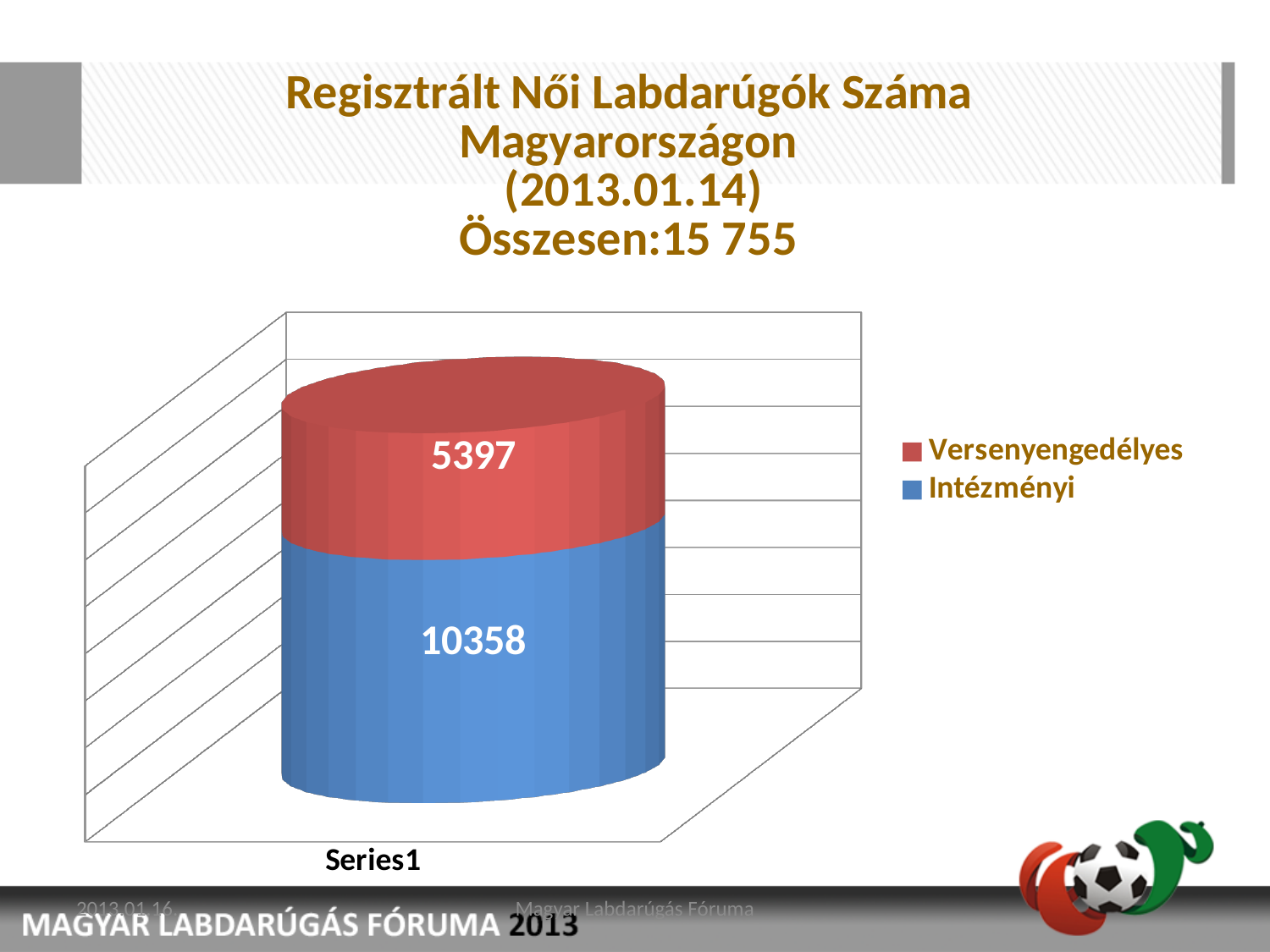
How many series does the legend list? 2 What is the value of the Versenyengedélyes segment? 5397 Which series has the smallest value in the chart? Versenyengedélyes What is the total of the stacked bar (Intézményi plus Versenyengedélyes)? 15 755 Which series has the larger value, Intézményi or Versenyengedélyes? Intézményi Which series has the largest value in the chart? Intézményi What is the value of the Intézményi segment? 10358 What kind of chart is shown on the slide? Stacked bar chart How many categories are shown on the x axis? 1 What is the category label shown under the bar? Series1 Which colour represents the Versenyengedélyes series in the legend? Red What is the difference between the Intézményi value and the Versenyengedélyes value? 4961